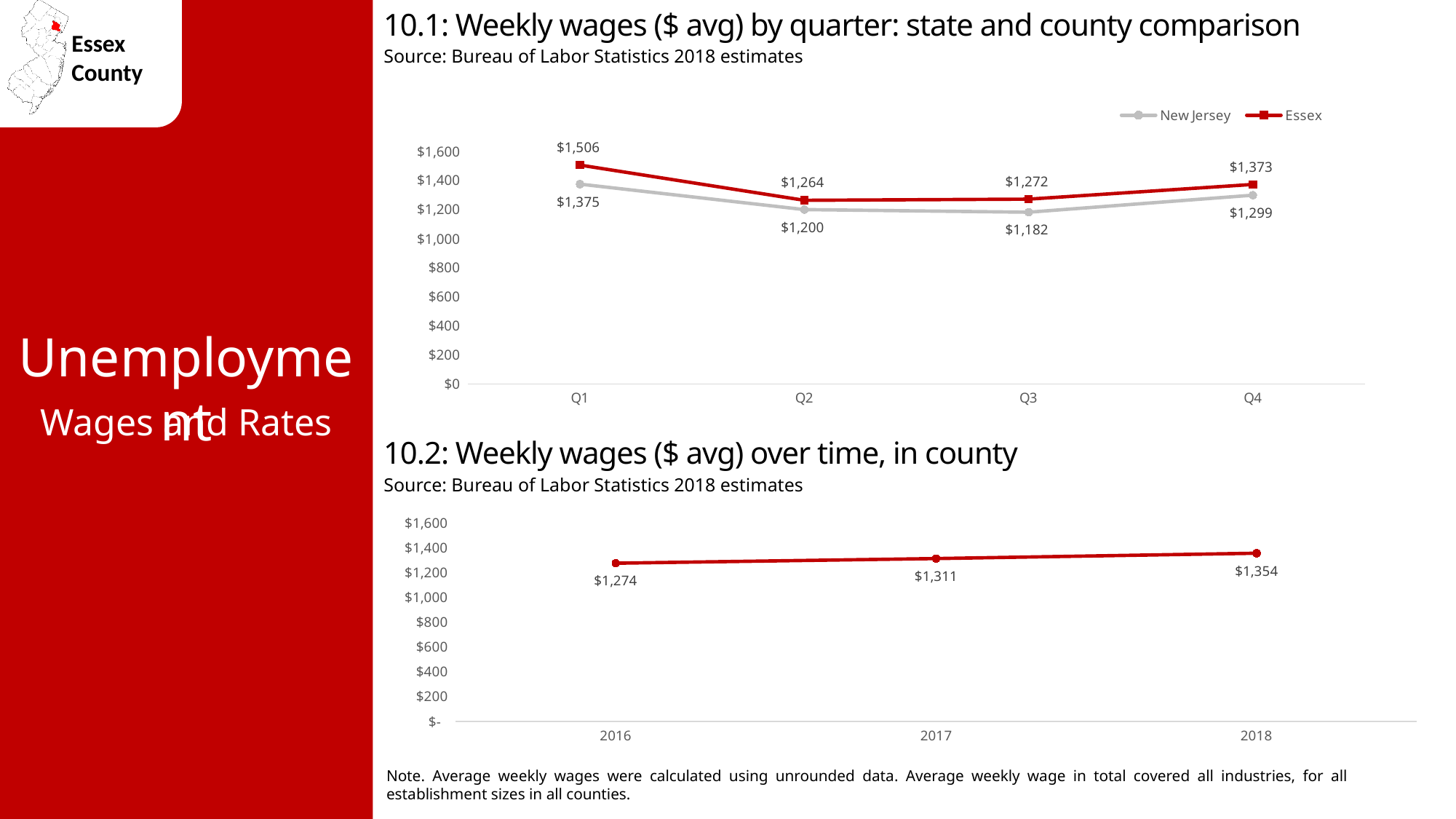
In chart 10.2, do weekly wages rise or fall from 2016 to 2018? rise In chart 10.1, what is the Essex weekly wage in Q1? $1,506 In chart 10.1, which quarter has the highest Essex weekly wage? Q1 In chart 10.1, what is the New Jersey weekly wage in Q3? $1,182 In chart 10.1, how many quarters are plotted on the x axis? 4 In chart 10.1, what is the difference between the Essex and New Jersey weekly wages in Q4? $74 In chart 10.2, what is the weekly wage in 2017? $1,311 In chart 10.1, which quarter has the lowest New Jersey weekly wage? Q3 In chart 10.2, what is the difference between the 2018 and 2016 weekly wages? $80 What kind of chart is chart 10.2? line chart In chart 10.1, how many series does the legend list? 2 In chart 10.1, which is larger in Q2: the Essex wage or the New Jersey wage? Essex